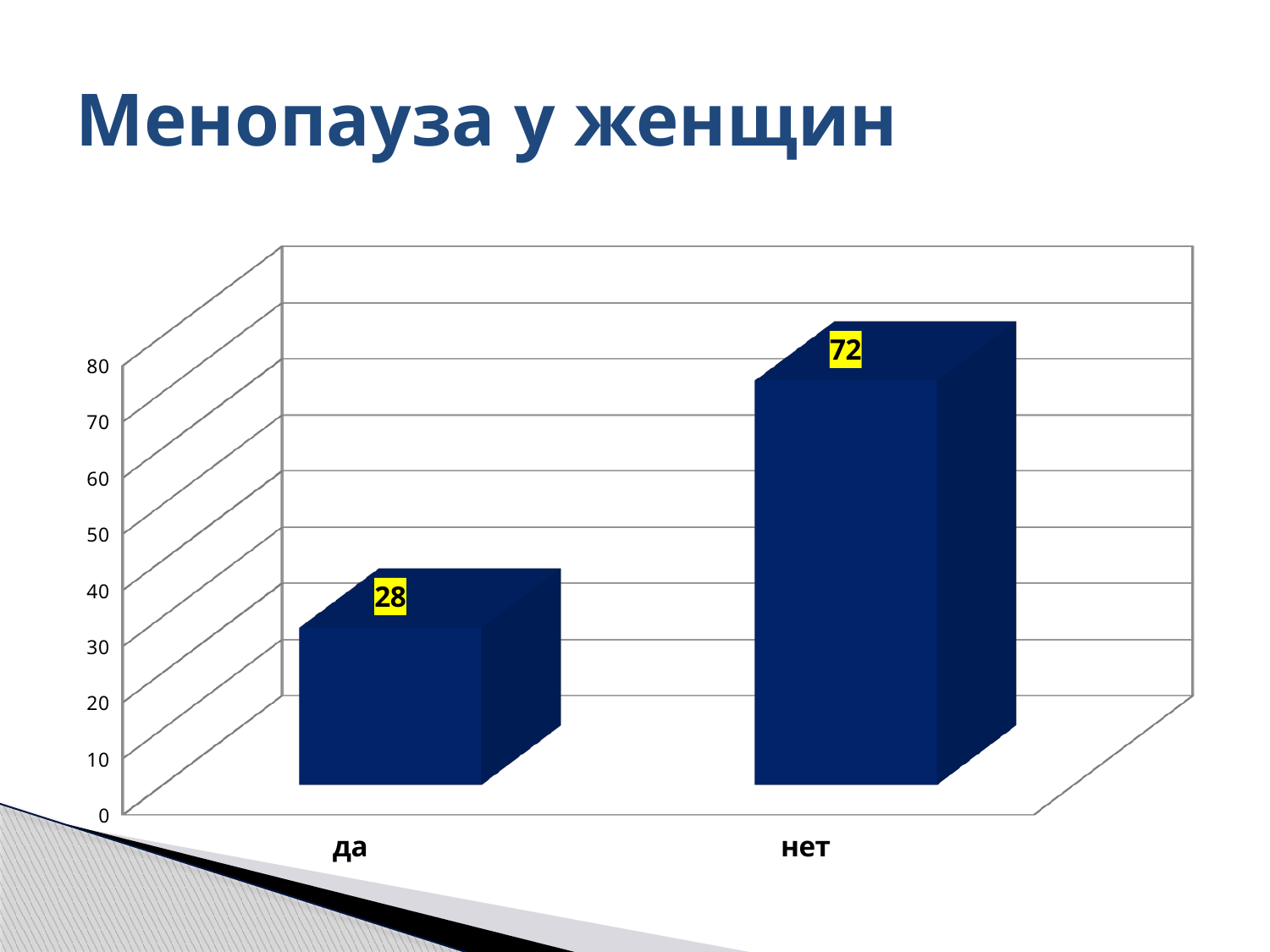
What is the title of the slide? Менопауза у женщин What kind of chart is shown on the slide? bar chart Which category has the highest value? нет Which is larger, the value for "да" or the value for "нет"? нет Is the value for "да" greater or less than 50? less How many categories are shown on the x axis? 2 What is the highest value shown on the vertical axis? 80 What is the difference between the values for "нет" and "да"? 44 What is the value for "да"? 28 Which category has the lowest value? да Is the value for "нет" greater or less than 60? greater What is the value for "нет"? 72